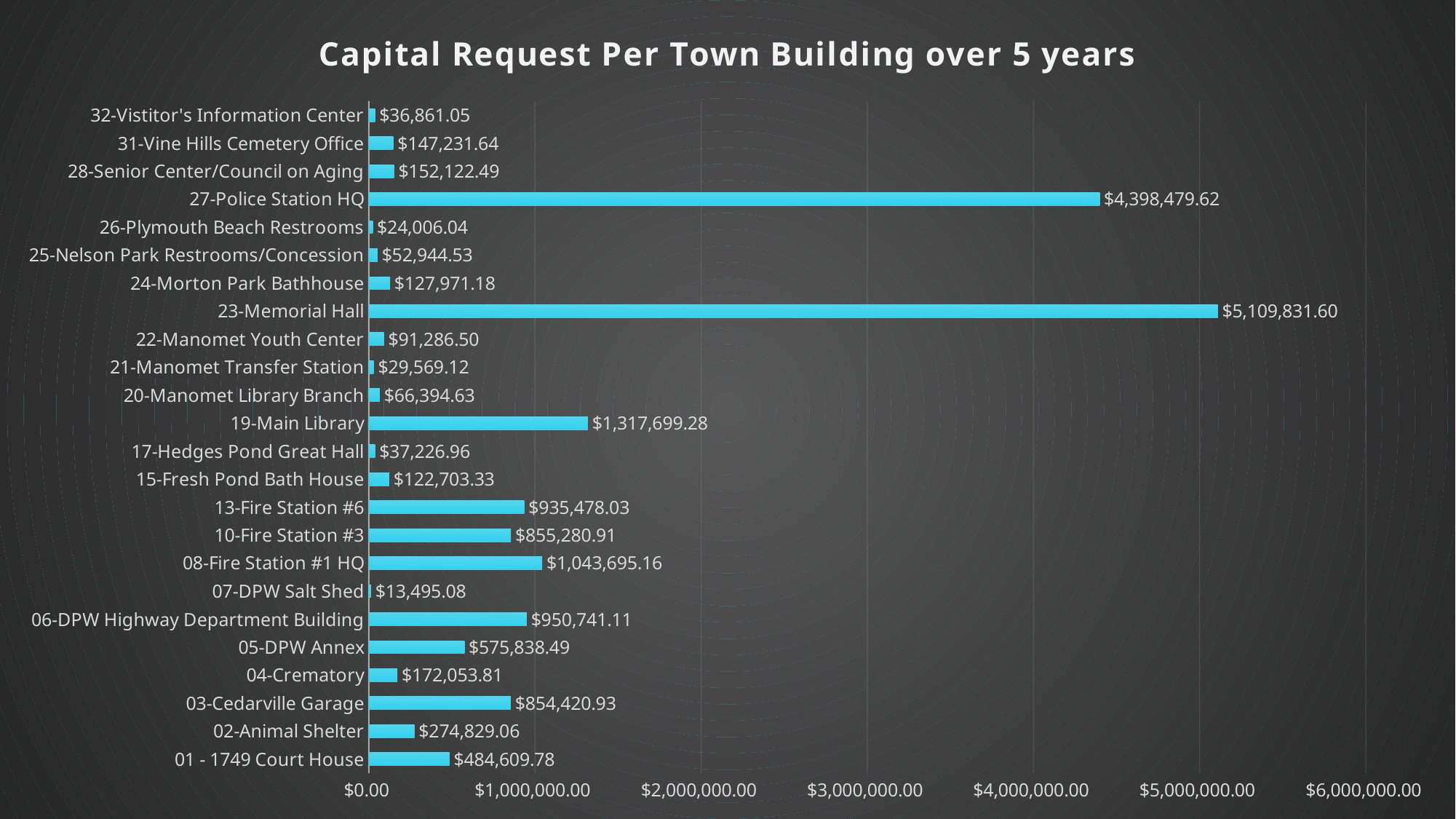
What is the capital request for 27-Police Station HQ? $4,398,479.62 Which has the larger capital request, 19-Main Library or 08-Fire Station #1 HQ? 19-Main Library What is the capital request for 02-Animal Shelter? $274,829.06 Which town building has the lowest capital request? 07-DPW Salt Shed What is the difference between the capital requests for 13-Fire Station #6 and 10-Fire Station #3? $80,197.12 Is the value for 27-Police Station HQ greater or less than $4,000,000.00? greater How many town buildings are shown in the chart? 24 What is the difference between the capital requests for 23-Memorial Hall and 27-Police Station HQ? $711,351.98 What is the title of the chart? Capital Request Per Town Building over 5 years What kind of chart is shown on the slide? bar chart What is the capital request for 19-Main Library? $1,317,699.28 Which town building has the highest capital request? 23-Memorial Hall